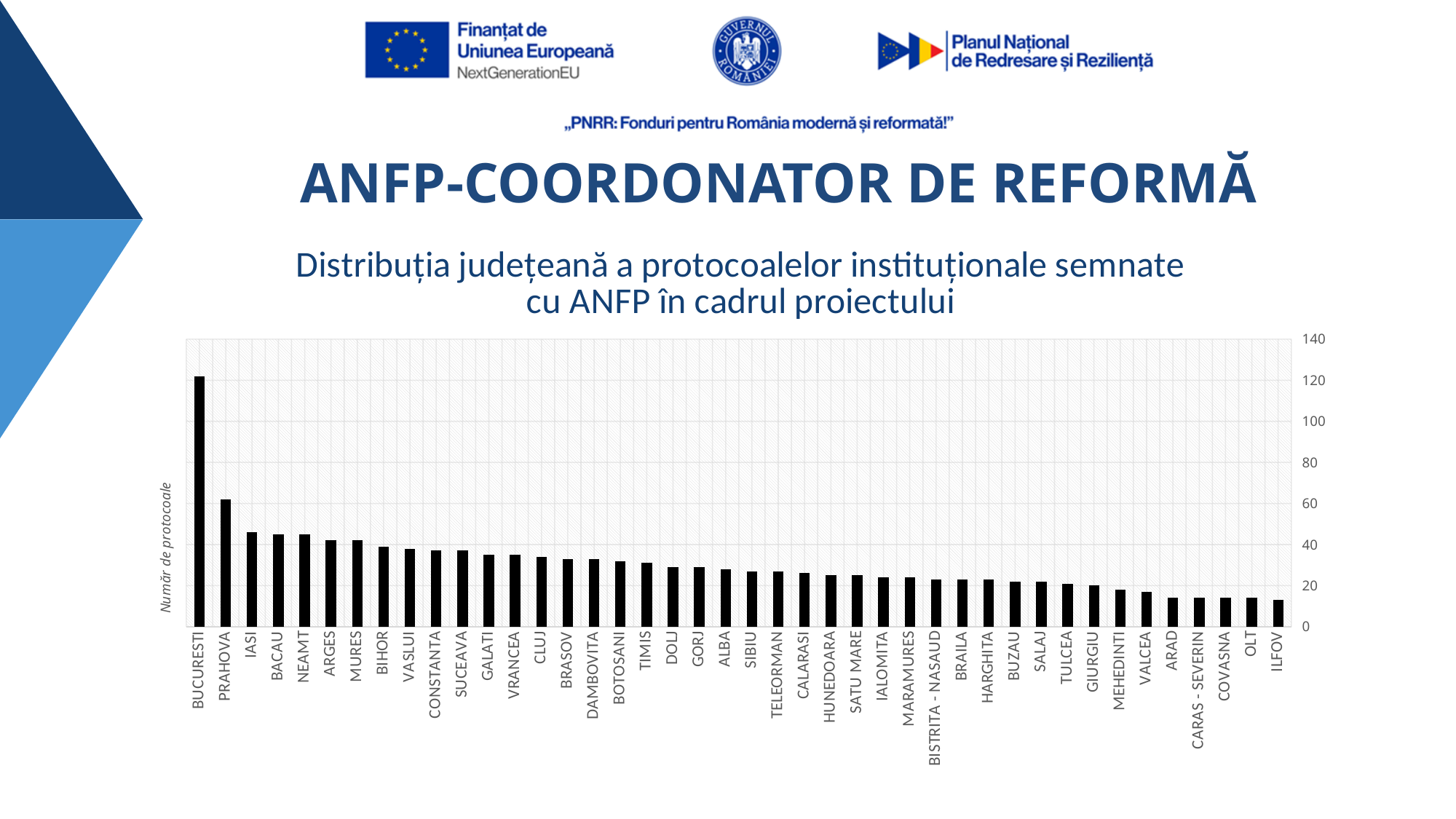
Do the values generally rise or fall moving from left to right along the x axis? fall What kind of chart is shown on the slide? bar chart Is the value for PRAHOVA greater or less than 80? less Which has a larger value, BUCURESTI or PRAHOVA? BUCURESTI Is the value for PRAHOVA greater or less than 40? greater Is the value for BUCURESTI greater or less than 100? greater Which has a larger value, BIHOR or ARAD? BIHOR How many counties (categories) are shown on the x axis of the chart? 42 Which county has the highest number of protocols in the chart? BUCURESTI What is the label on the vertical axis of the chart? Număr de protocoale